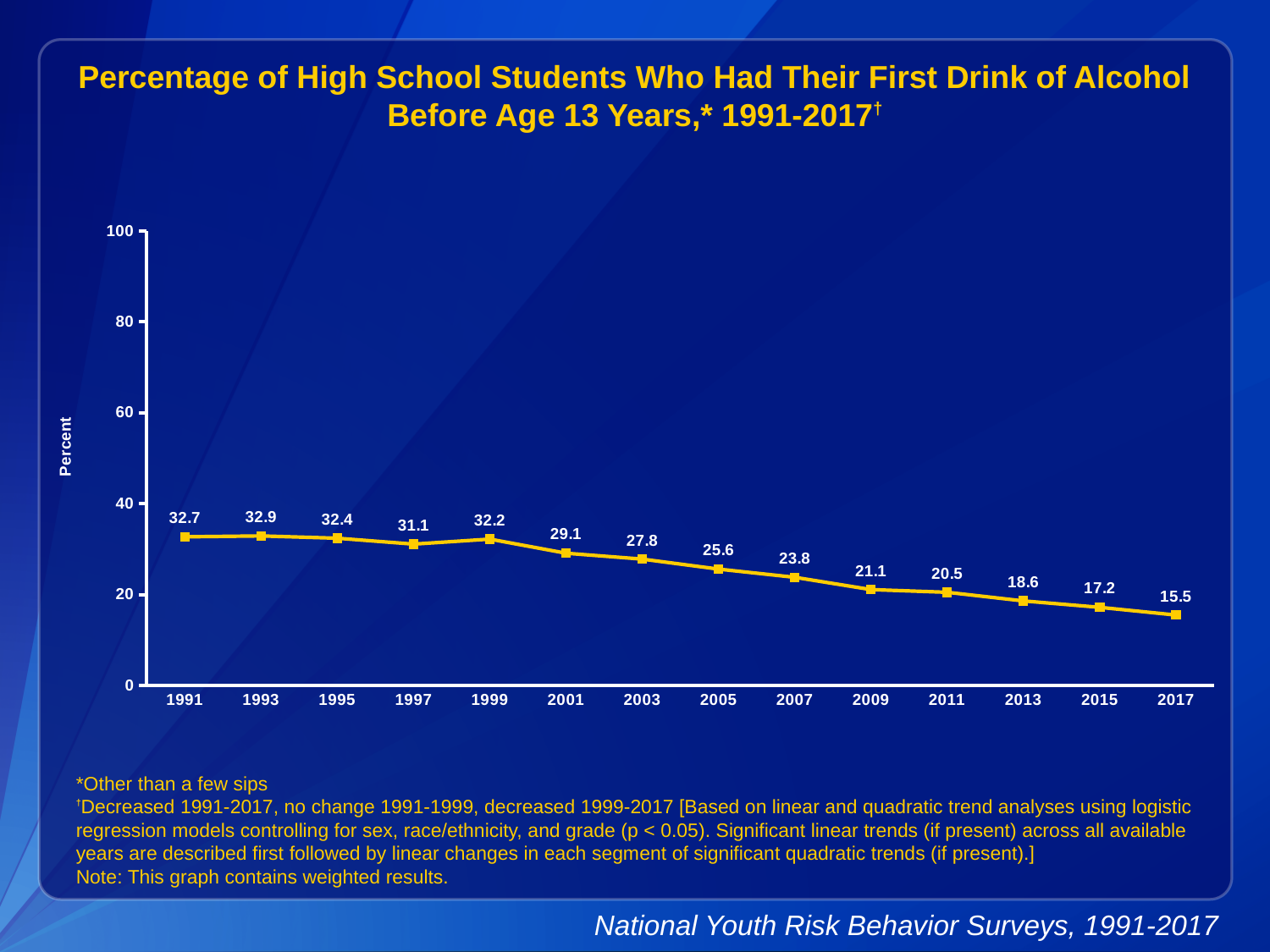
Do the values generally rise or fall from 1999 to 2017? fall How many years are plotted on the x axis? 14 Is the value for 2009 greater or less than 20? greater What is the value plotted for 2005? 25.6 Which year has the lowest value on the chart? 2017 Which year has the highest value on the chart? 1993 What kind of chart is shown on the slide? line chart What is the value plotted for 2017? 15.5 What percentage of high school students had their first drink of alcohol before age 13 in 1991? 32.7 Which year has a larger value, 1999 or 2001? 1999 What is the label on the y axis? Percent What is the difference between the 1991 value and the 2017 value? 17.2